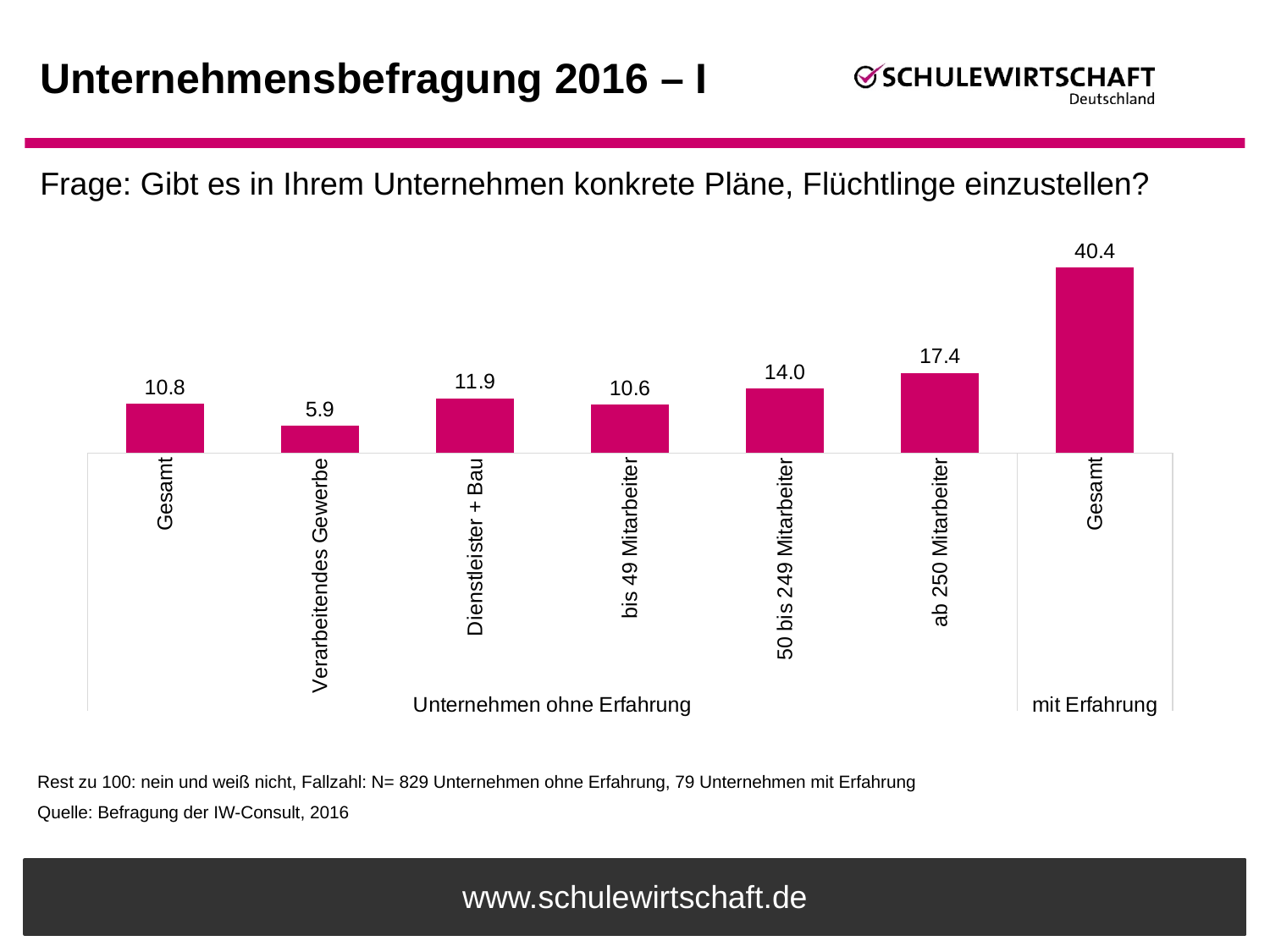
Which category has the highest value? Gesamt (mit Erfahrung) What is the value for "ab 250 Mitarbeiter"? 17.4 How many bars are shown in the chart? 7 What is the value for "Gesamt" in the "Unternehmen ohne Erfahrung" group? 10.8 What is the value for "Verarbeitendes Gewerbe"? 5.9 Which category has the lowest value? Verarbeitendes Gewerbe What is the value for "Gesamt" in the "mit Erfahrung" group? 40.4 Which is larger, the value for "Dienstleister + Bau" or the value for "50 bis 249 Mitarbeiter"? 50 bis 249 Mitarbeiter What kind of chart is shown on the slide? Bar chart What is the difference between the values for "ab 250 Mitarbeiter" and "bis 49 Mitarbeiter"? 6.8 What is the difference between "Gesamt" in the "mit Erfahrung" group and "Gesamt" in the "Unternehmen ohne Erfahrung" group? 29.6 What are the two group labels shown below the category axis? Unternehmen ohne Erfahrung; mit Erfahrung